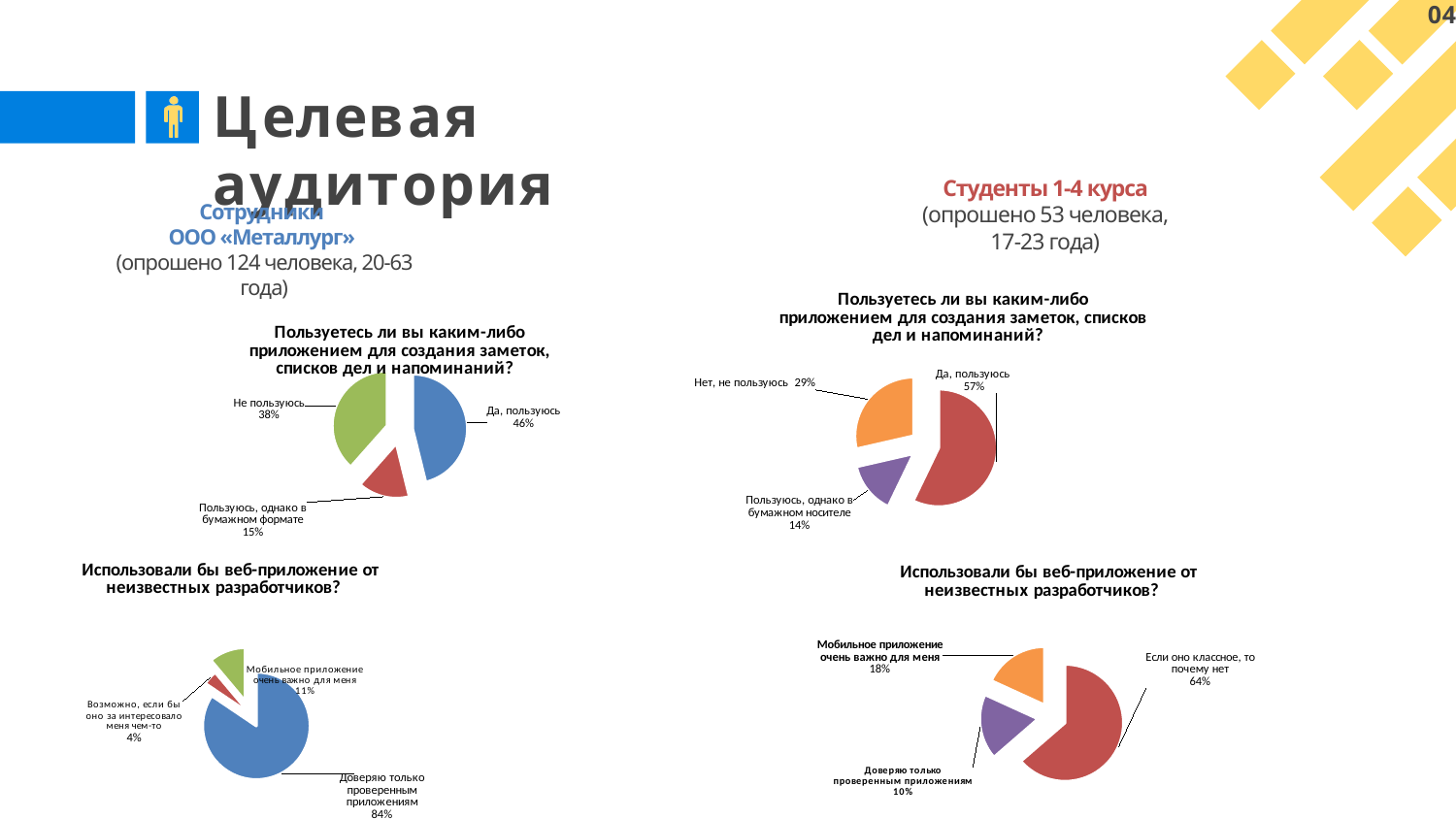
What type of chart is used for all four charts on the slide? Pie chart In the top-right pie chart (students), what share answered «Нет, не пользуюсь»? 29% In the bottom-left pie chart (employees), what is the difference between «Доверяю только проверенным приложениям» and «Мобильное приложение очень важно для меня»? 73% In the top-left pie chart (employees, note-taking app usage), what share answered «Да, пользуюсь»? 46% Which is larger: the «Да, пользуюсь» share in the top-left chart (employees) or in the top-right chart (students)? Top-right (students), 57% In the top-left pie chart (employees), which answer has the smallest share? Пользуюсь, однако в бумажном формате In the top-left pie chart (employees), what share answered «Не пользуюсь»? 38% In the bottom-left pie chart (employees, web app from unknown developers), what share answered «Доверяю только проверенным приложениям»? 84% In the top-right pie chart (students), what is the difference between «Да, пользуюсь» and «Нет, не пользуюсь»? 28% In the bottom-right pie chart (students), which answer has the smallest share? Доверяю только проверенным приложениям In the top-right pie chart (students, note-taking app usage), what share answered «Да, пользуюсь»? 57% In the bottom-right pie chart (students, web app from unknown developers), what share answered «Если оно классное, то почему нет»? 64%